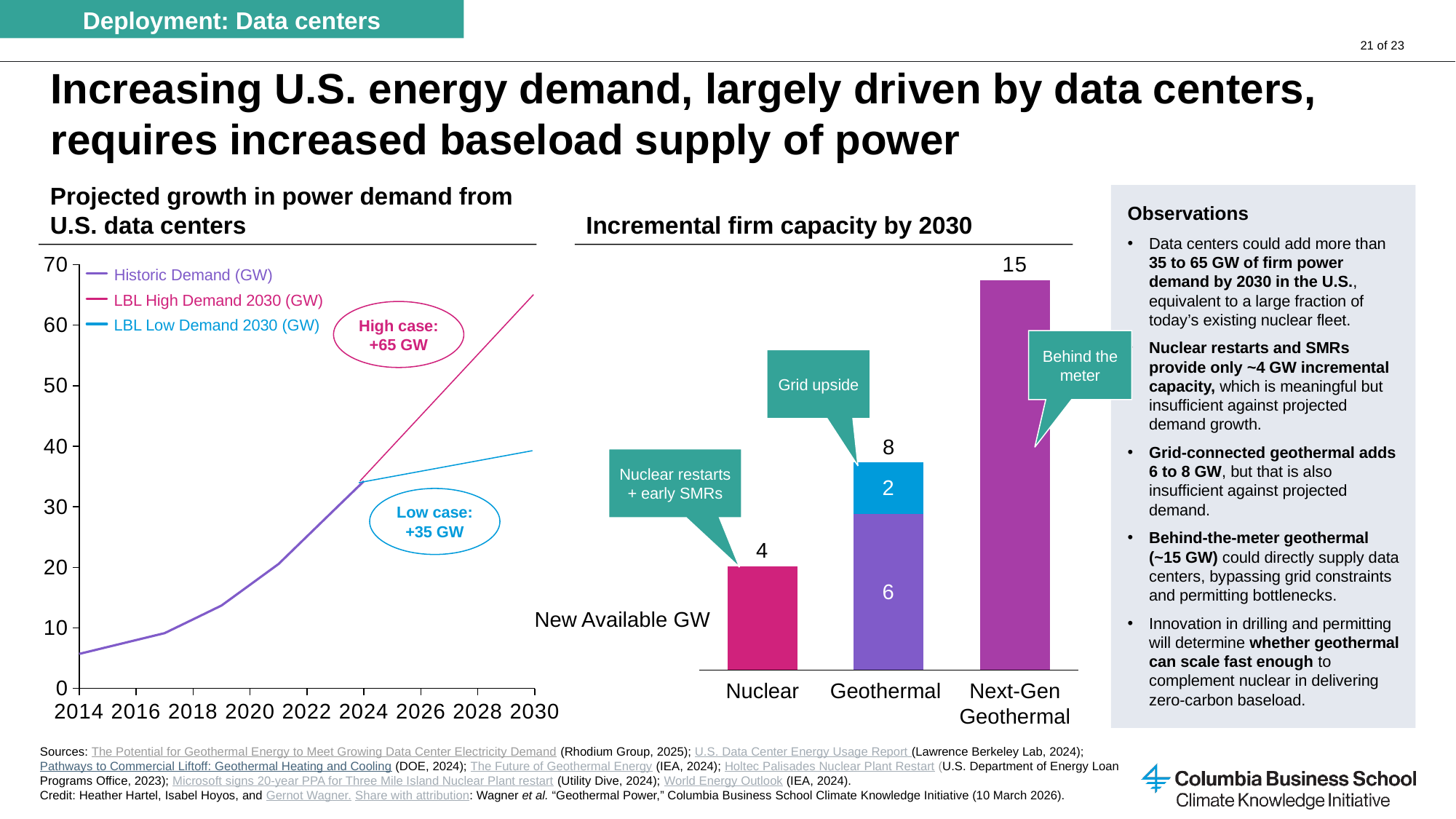
In the 'Incremental firm capacity by 2030' chart, what is the value for Nuclear? 4 In the 'Incremental firm capacity by 2030' chart, what is the value of the 'Grid upside' segment of the Geothermal bar? 2 In the 'Incremental firm capacity by 2030' chart, what is the total of the stacked Geothermal bar? 8 In the 'Projected growth in power demand from U.S. data centers' chart, how many series does the legend list? 3 In the 'Incremental firm capacity by 2030' chart, what is the difference between the Next-Gen Geothermal value and the Nuclear value? 11 In the 'Projected growth in power demand from U.S. data centers' chart, is the LBL High Demand value in 2030 greater or less than 60? greater What kind of chart is 'Incremental firm capacity by 2030'? Bar chart In the 'Incremental firm capacity by 2030' chart, which category has the lowest value? Nuclear In the 'Projected growth in power demand from U.S. data centers' chart, does the Historic Demand line rise or fall from 2014 to 2024? Rise In the 'Incremental firm capacity by 2030' chart, which category has the highest value? Next-Gen Geothermal In the 'Incremental firm capacity by 2030' chart, how many categories are shown on the x axis? 3 In the 'Incremental firm capacity by 2030' chart, what is the value for Next-Gen Geothermal? 15